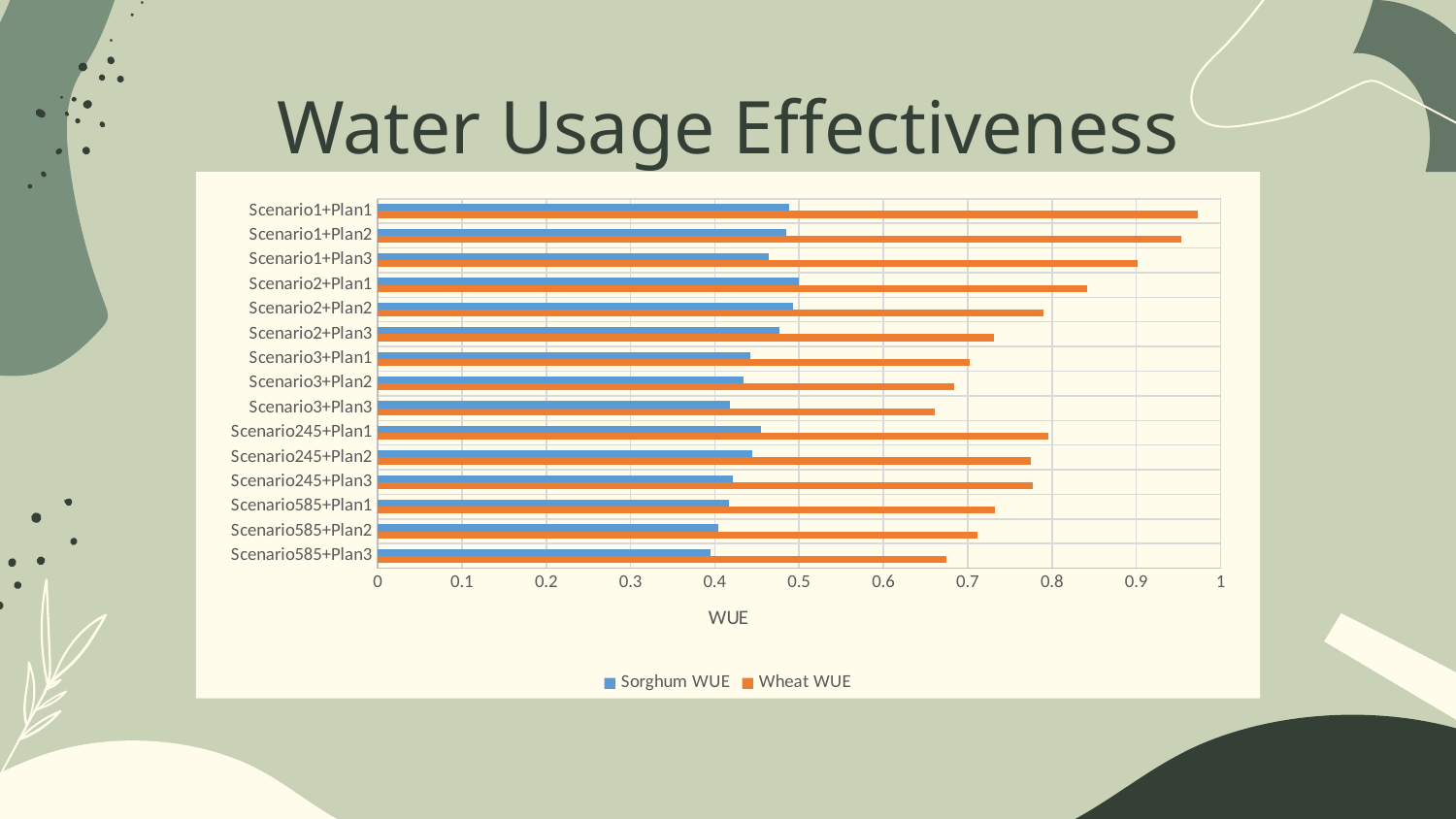
Is the Wheat WUE value for Scenario2+Plan1 greater or less than 0.8? greater Is the Wheat WUE value for Scenario3+Plan3 greater or less than 0.7? less What kind of chart is shown on the slide? Bar chart Which has the larger Sorghum WUE value: Scenario2+Plan1 or Scenario585+Plan3? Scenario2+Plan1 How many scenario-plan categories are plotted on the chart? 15 How many series does the legend list? 2 What is the title of the horizontal axis? WUE Is the Sorghum WUE value for Scenario585+Plan3 greater or less than 0.5? less Which has the larger Wheat WUE value: Scenario1+Plan1 or Scenario585+Plan3? Scenario1+Plan1 For Scenario1+Plan1, which is larger: Sorghum WUE or Wheat WUE? Wheat WUE Which colour represents the Wheat WUE series? Orange